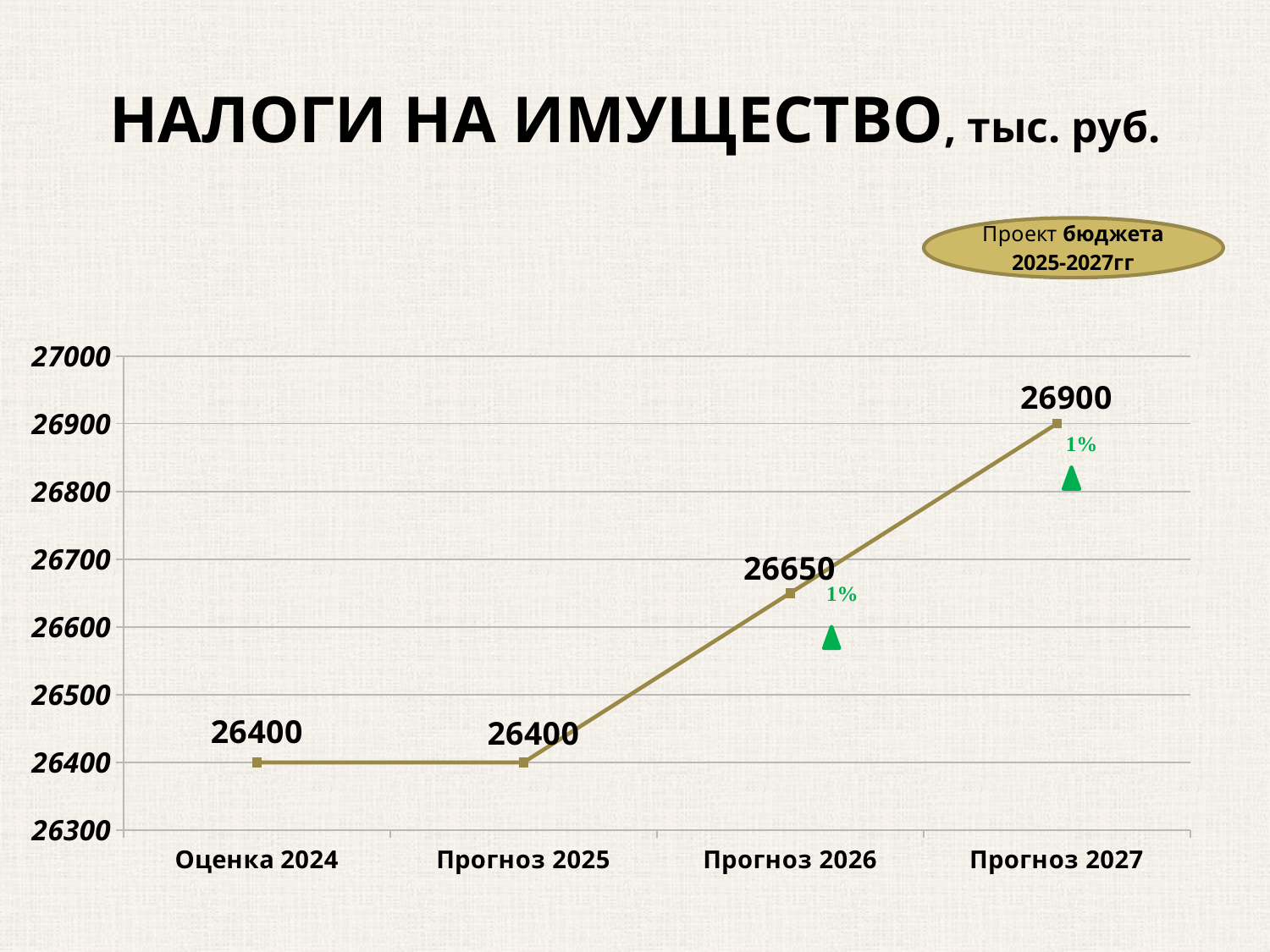
How many categories are shown on the x axis? 4 What kind of chart is shown on the slide? line chart What is the title of the chart? НАЛОГИ НА ИМУЩЕСТВО, тыс. руб. Is the value for Прогноз 2026 greater or less than 26700? less What is the value for Прогноз 2027? 26900 Which is larger, the value for Прогноз 2026 or the value for Прогноз 2025? Прогноз 2026 What is the value for Прогноз 2026? 26650 What is the difference between the values for Прогноз 2026 and Прогноз 2025? 250 What is the difference between the values for Прогноз 2027 and Прогноз 2026? 250 What is the value for Оценка 2024? 26400 Which category has the highest value? Прогноз 2027 Do the values rise or fall from Прогноз 2025 to Прогноз 2027? rise